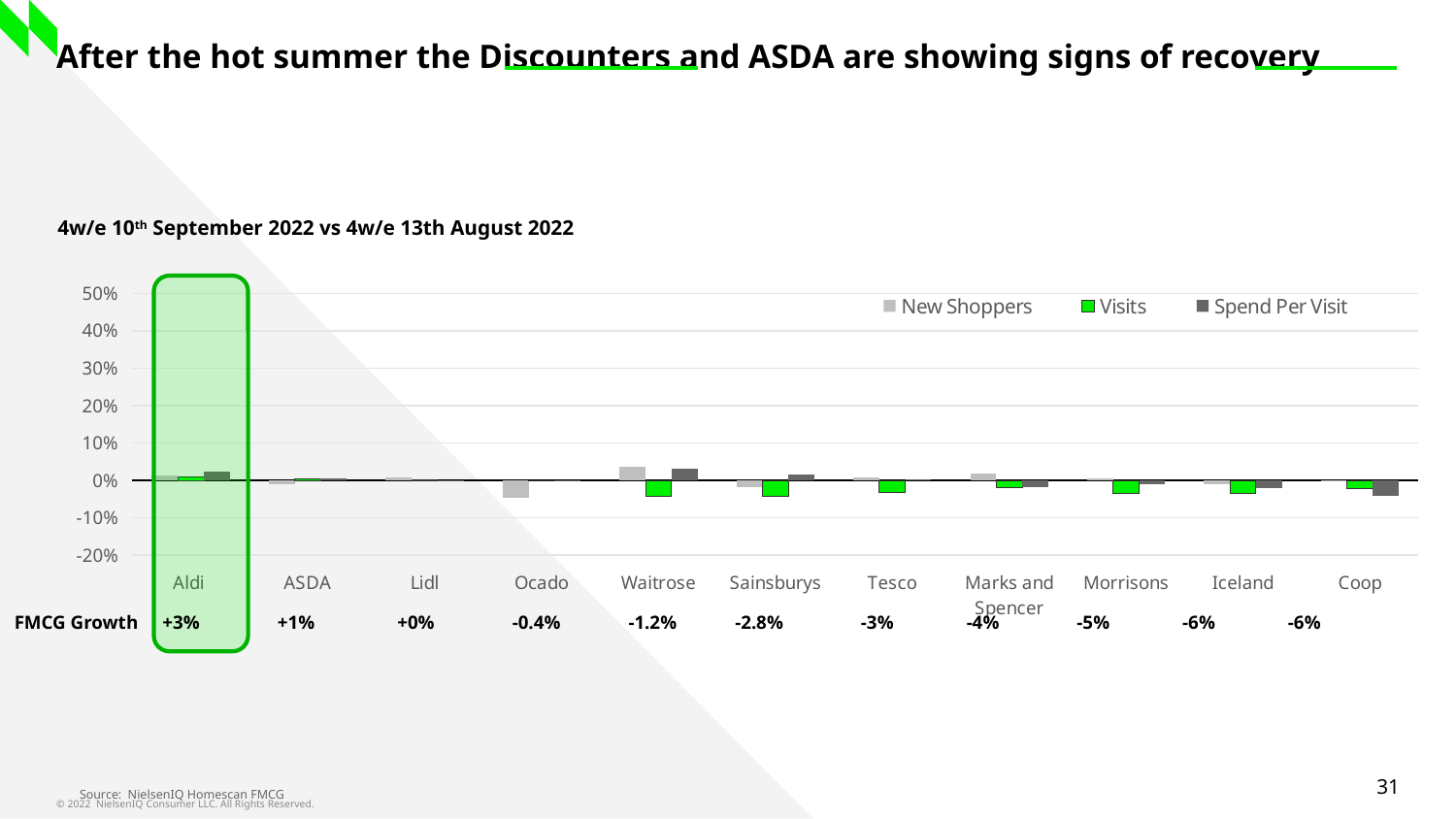
Which retailer has the highest FMCG Growth figure shown below the chart? Aldi What is the title printed above the chart? 4w/e 10th September 2022 vs 4w/e 13th August 2022 What is the FMCG Growth figure shown for Aldi? +3% Is the Visits value for Waitrose greater or less than 0%? less Which retailer is highlighted with a green box on the chart? Aldi What kind of chart is shown on the slide? bar chart How many retailers are shown along the x axis of the chart? 11 Is the New Shoppers value for Waitrose greater or less than 0%? greater How many series does the chart legend list? 3 Which has the larger FMCG Growth figure, ASDA or Lidl? ASDA Is the Visits value for Aldi greater or less than 10%? less What is the FMCG Growth figure shown for Tesco? -3%